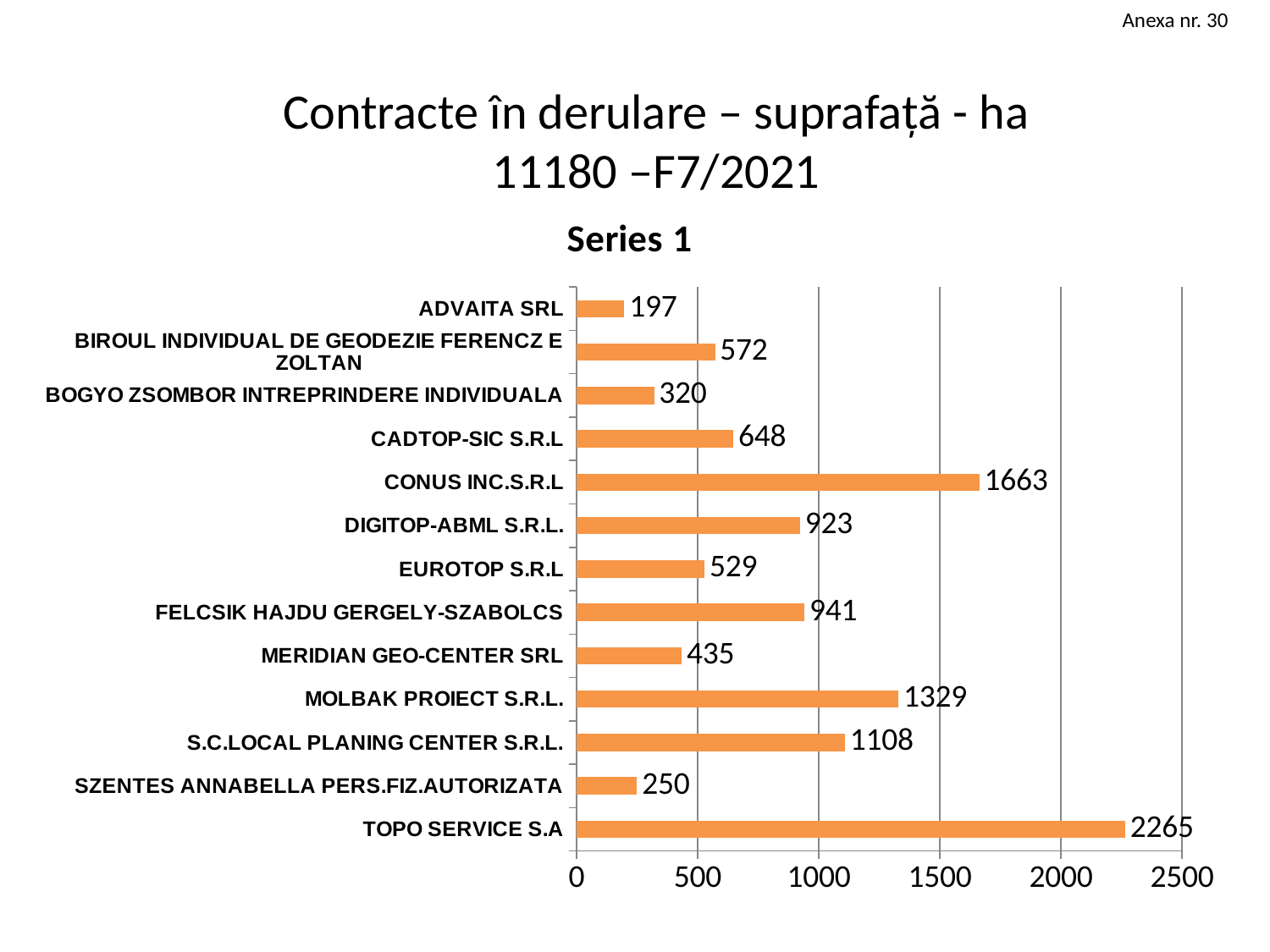
What is the value for MERIDIAN GEO-CENTER SRL? 435 Which category has the highest value? TOPO SERVICE S.A Which category has the lowest value? ADVAITA SRL What kind of chart is shown on the slide? bar chart Which is larger, the value for DIGITOP-ABML S.R.L. or the value for FELCSIK HAJDU GERGELY-SZABOLCS? FELCSIK HAJDU GERGELY-SZABOLCS How many categories are shown in the chart? 13 What is the difference between the values for CADTOP-SIC S.R.L and BOGYO ZSOMBOR INTREPRINDERE INDIVIDUALA? 328 What is the value for CONUS INC.S.R.L? 1663 What is the value for SZENTES ANNABELLA PERS.FIZ.AUTORIZATA? 250 Is the value for MOLBAK PROIECT S.R.L. greater or less than 1000? greater What is the difference between the values for TOPO SERVICE S.A and CONUS INC.S.R.L? 602 What is the chart title shown above the plot area? Series 1